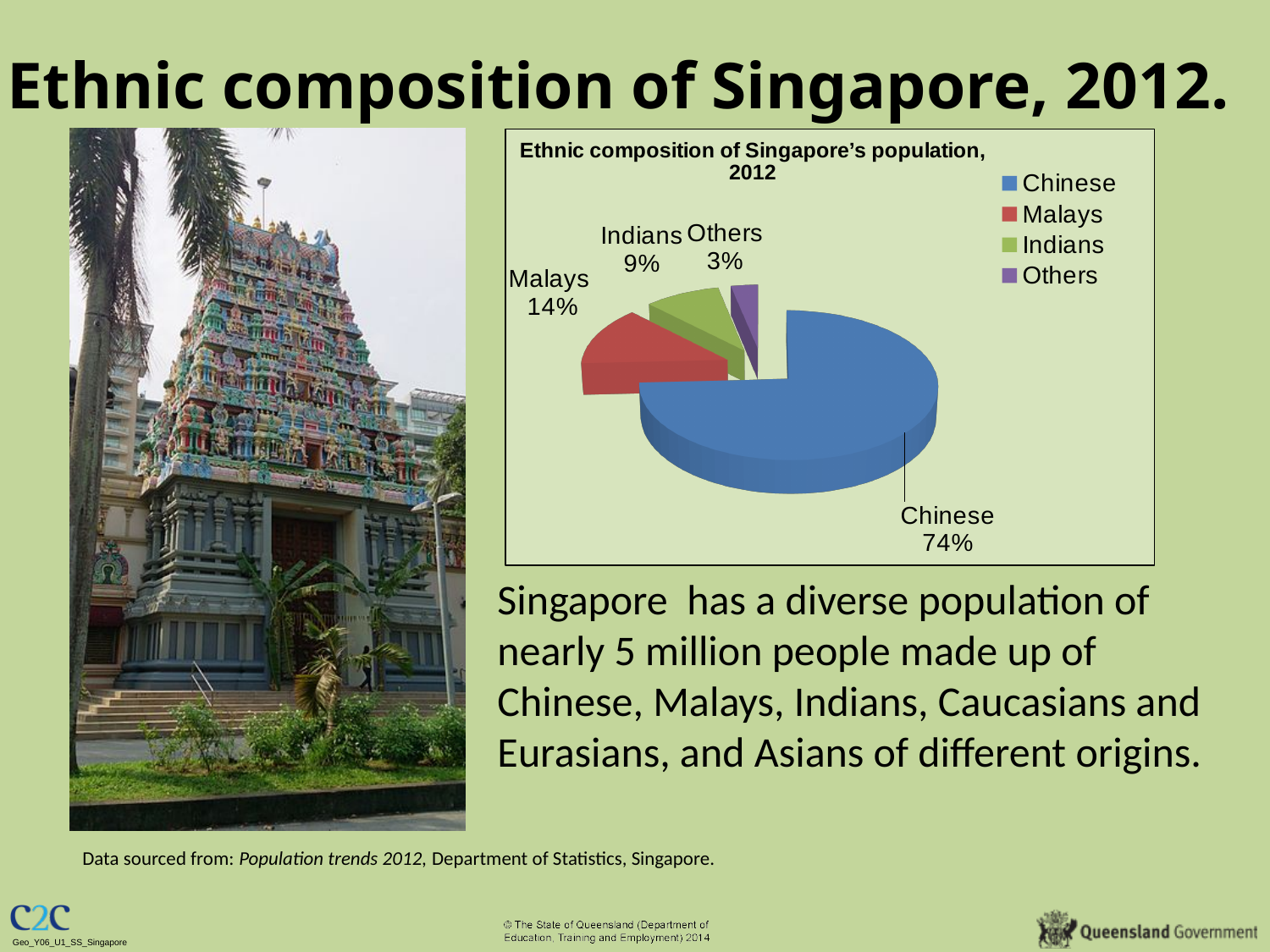
What is the title of the chart? Ethnic composition of Singapore's population, 2012 What percentage of Singapore's population is Chinese according to the chart? 74% What is the difference in percentage points between the Chinese and Malays shares? 60 What percentage of Singapore's population is Others according to the chart? 3% Which is larger, the share for Malays or the share for Indians? Malays How many entries does the chart legend list? 4 How many categories are shown in the pie chart? 4 What percentage of Singapore's population is Indians according to the chart? 9% Which ethnic group has the smallest share of the pie? Others What percentage of Singapore's population is Malays according to the chart? 14% Which ethnic group has the largest share of the pie? Chinese What type of chart is shown on the slide? Pie chart